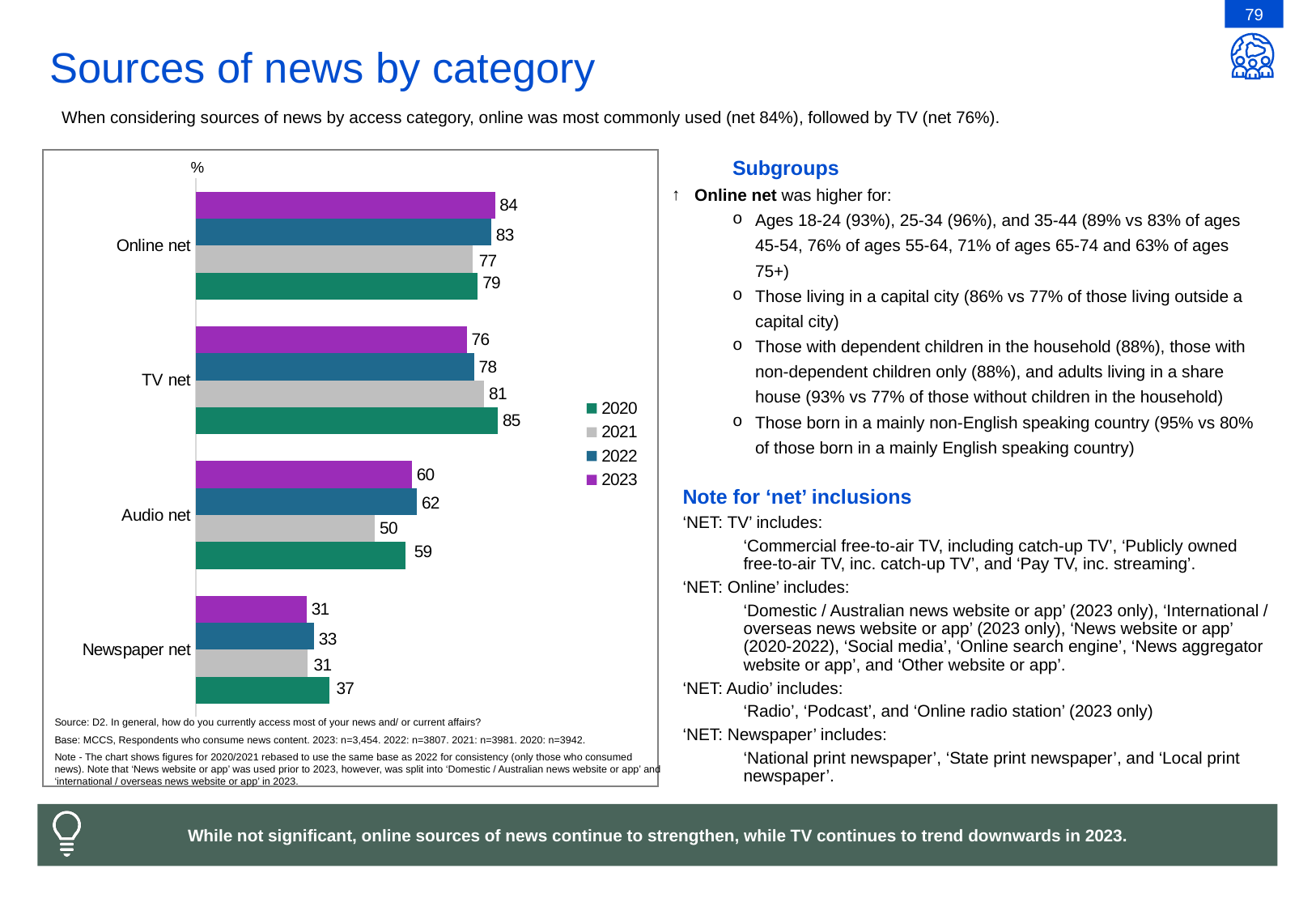
Which category has the highest 2023 value? Online net What is the 2021 value for Audio net? 50 How many categories are shown on the chart? 4 What kind of chart is shown on the slide? Bar chart What is the 2023 value for Online net? 84 What is the 2022 value for Newspaper net? 33 Which category has the lowest 2020 value? Newspaper net What is the 2020 value for TV net? 85 What is the difference between the 2020 and 2023 values for TV net? 9 How many series does the legend list? 4 Which is larger for Audio net, the 2022 value or the 2021 value? 2022 Which colour represents 2023 in the legend? Purple